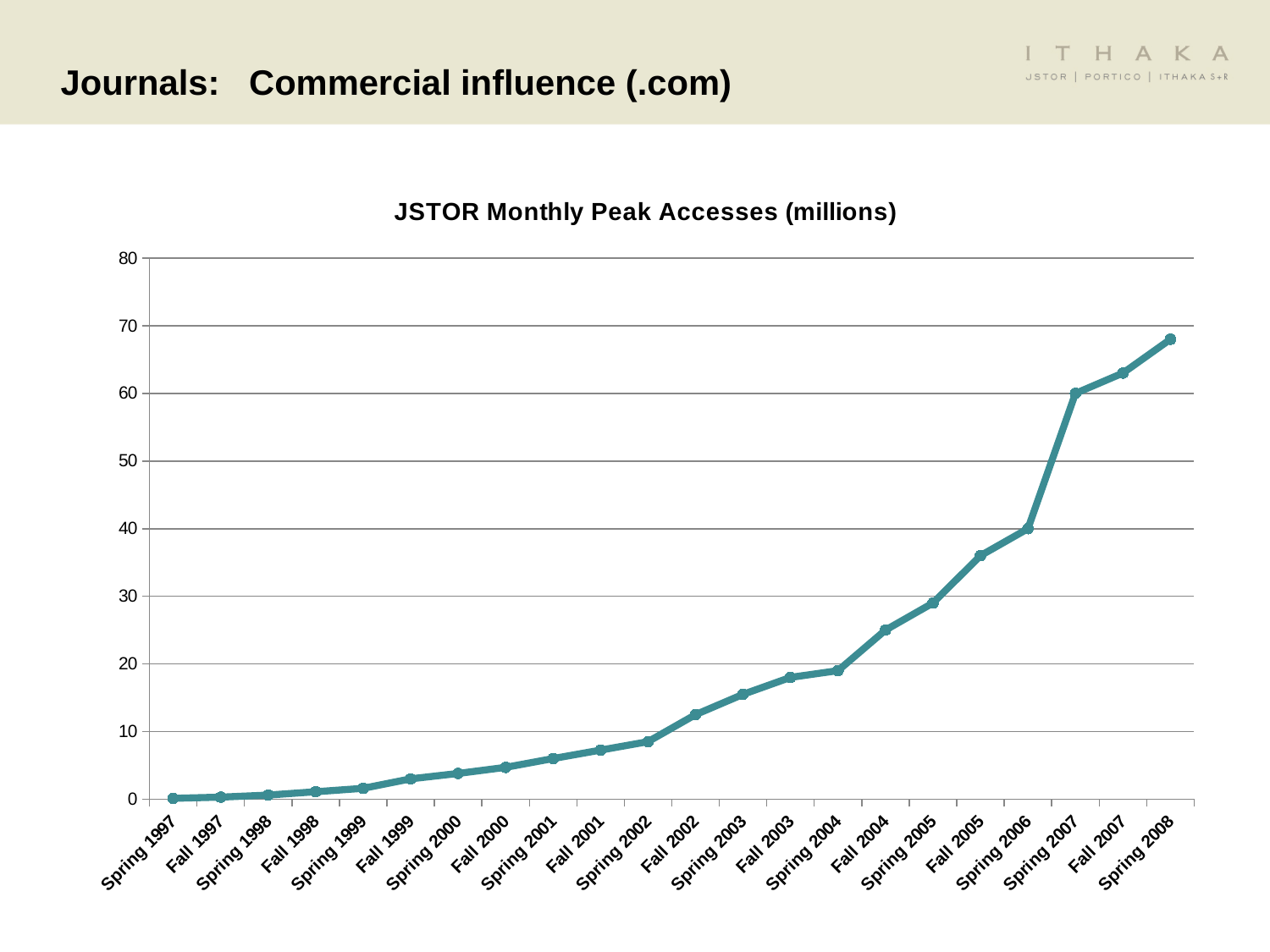
Which period has the lowest value? Spring 1997 What is the title of the chart? JSTOR Monthly Peak Accesses (millions) How many data points are plotted on the chart? 22 Do the values generally rise or fall from Spring 1997 to Spring 2008? Rise Is the value for Spring 2008 greater or less than 60? greater Is the value for Fall 2004 greater or less than 30? less What kind of chart is shown on the slide? Line chart Which is larger, the value for Fall 2005 or the value for Fall 2003? Fall 2005 What is the value for Spring 2007? 60 Is the value for Spring 2002 greater or less than 10? less Which period has the highest value? Spring 2008 What is the value for Spring 2006? 40